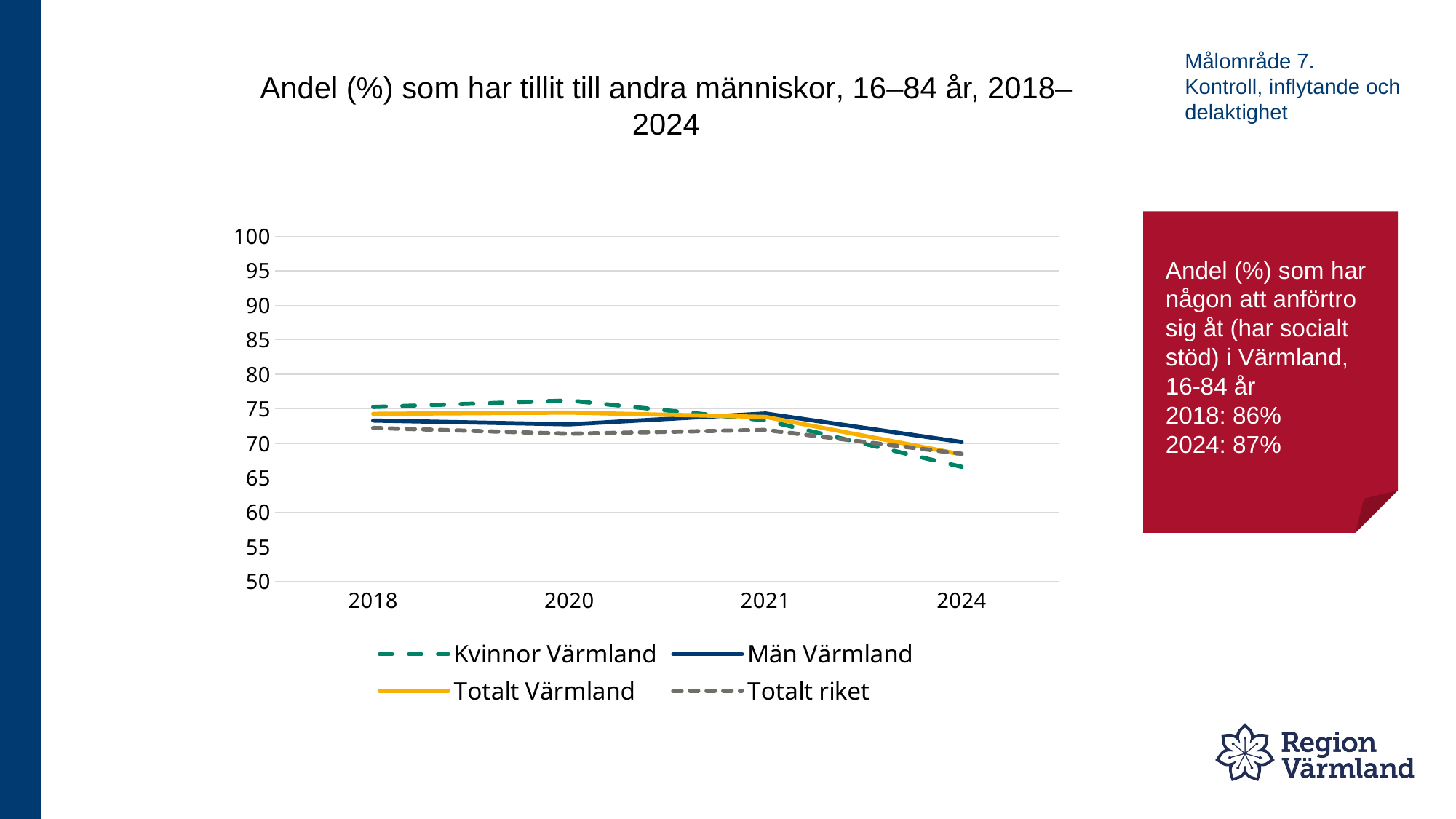
Is the value for Kvinnor Värmland in 2024 greater or less than 70? less What kind of chart is shown on the slide? Line chart Which series is drawn with a solid yellow line? Totalt Värmland Which series has the highest value in 2024? Män Värmland Does the value for Kvinnor Värmland rise or fall from 2021 to 2024? Fall Which series has the highest value in 2020? Kvinnor Värmland Is the value for Kvinnor Värmland in 2018 greater or less than 70? greater Is the value for Totalt riket in 2018 greater or less than 75? less How many years are shown on the x axis? 4 How many series does the legend list? 4 Which series has the lowest value in 2024? Kvinnor Värmland In 2020, which is larger: Kvinnor Värmland or Totalt riket? Kvinnor Värmland